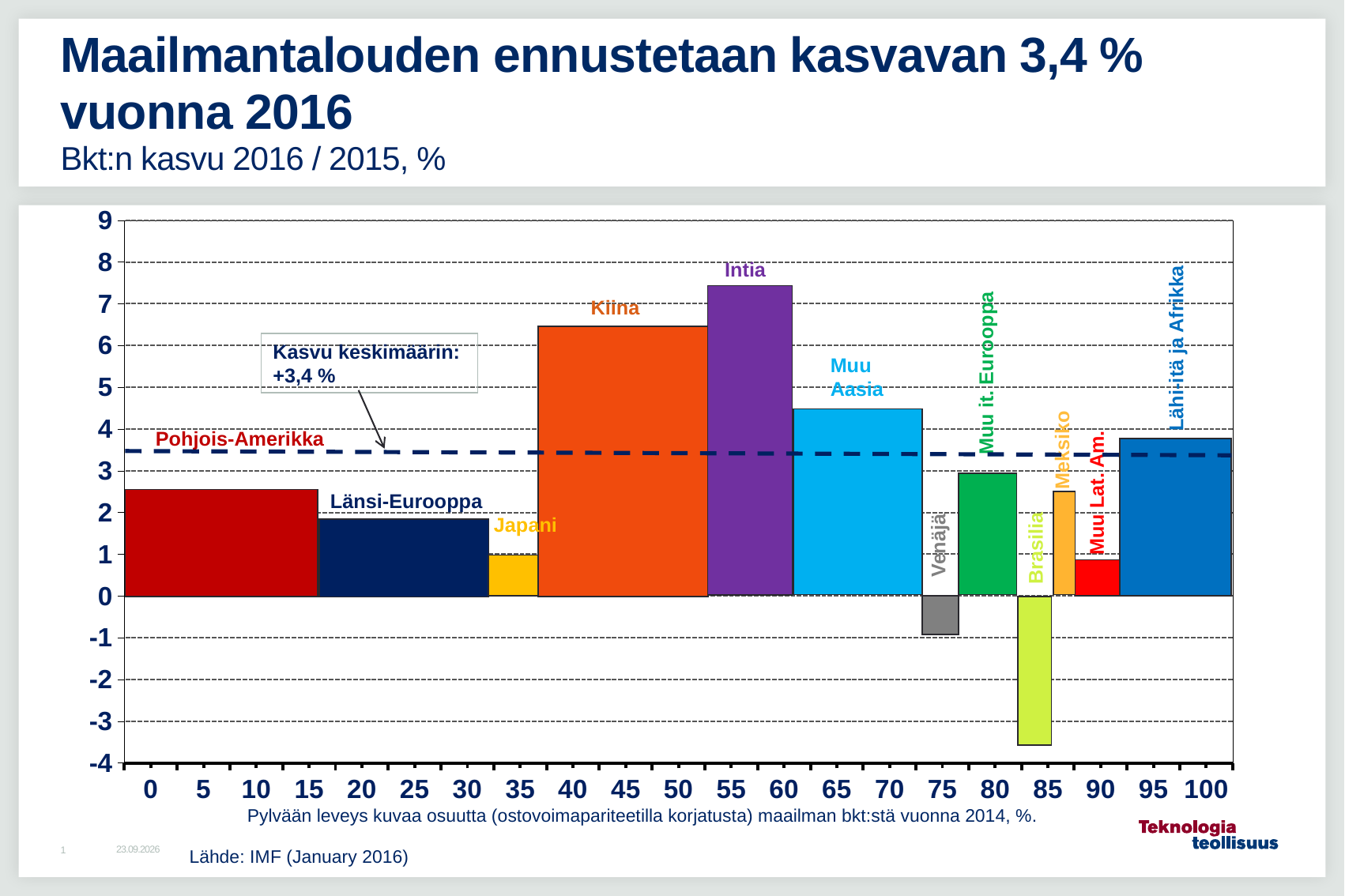
Which region has the lowest GDP growth forecast in the chart? Brasilia Is the value for Muu Aasia greater or less than 4? greater What average growth value is given in the annotation box on the chart? +3,4 % Is the value for Kiina greater or less than 6? greater Which has the higher growth forecast, Pohjois-Amerikka or Länsi-Eurooppa? Pohjois-Amerikka According to the note below the chart, what does the width of each bar represent? Share of world GDP in 2014 (PPP-adjusted), % Which region has the highest GDP growth forecast in the chart? Intia Which has the higher growth forecast, Kiina or Intia? Intia Is the value for Pohjois-Amerikka greater or less than 3? less What type of chart is shown on the slide? bar chart How many regions or countries are shown as bars in the chart? 12